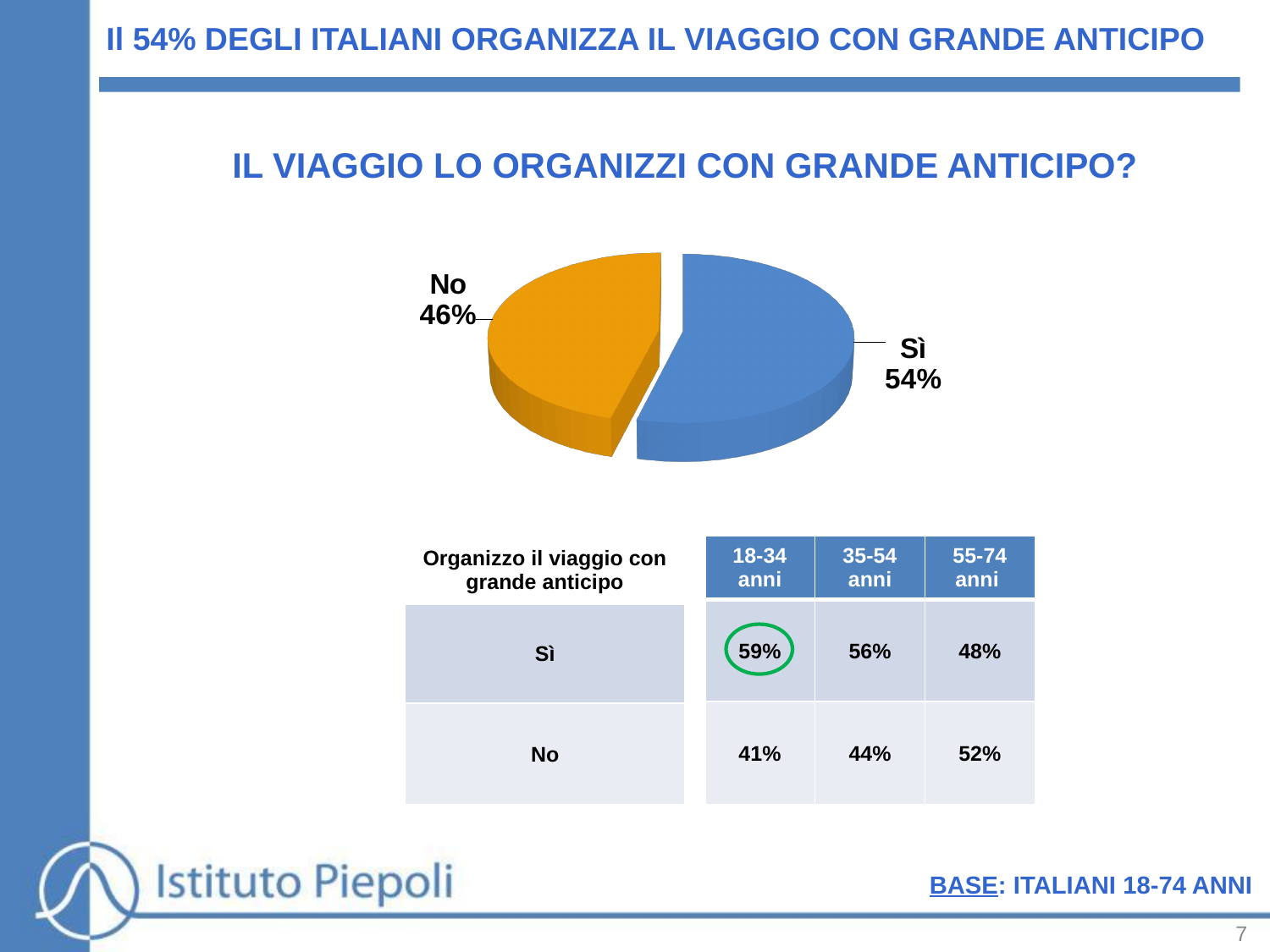
Which slice of the pie chart is the smallest? No Which is larger in the pie chart, the "Sì" slice or the "No" slice? Sì What kind of chart is shown on the slide? pie chart What colour is the "No" slice of the pie chart? orange What colour is the "Sì" slice of the pie chart? blue What percentage of the pie chart is labelled "No"? 46% What percentage of the pie chart is labelled "Sì"? 54% What is the difference in percentage points between the "Sì" and "No" slices of the pie chart? 8 What share of the pie chart does the "No" slice represent? 46% How many slices does the pie chart have? 2 Which slice of the pie chart is the largest? Sì Is the value of the "Sì" slice in the pie chart greater or less than 50%? greater